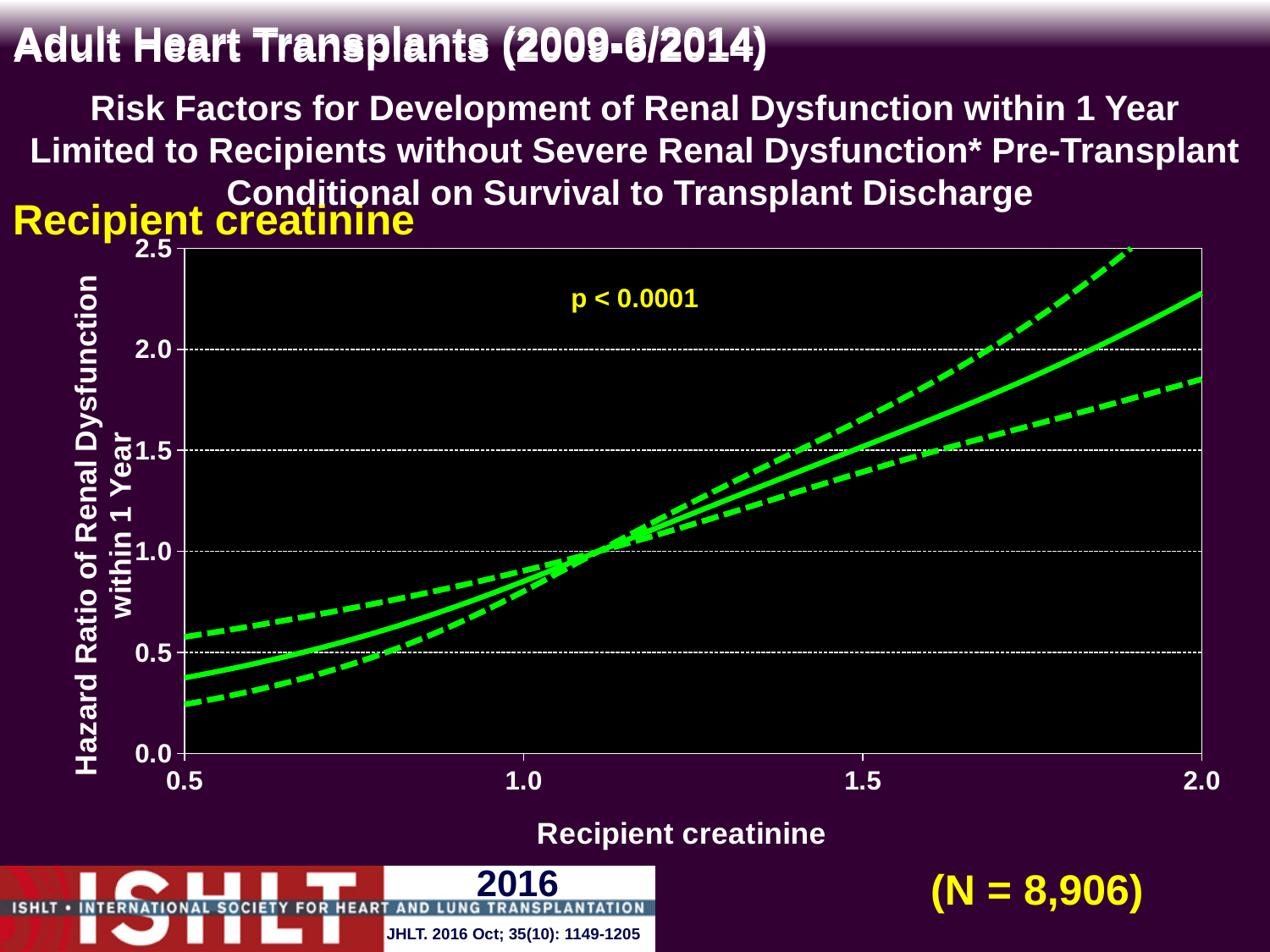
Does the hazard ratio rise or fall as recipient creatinine increases along the x axis? rises Is the lower dashed line at a recipient creatinine of 2.0 greater or less than 1.5? greater What is the label of the x axis? Recipient creatinine Is the hazard ratio on the solid line at a recipient creatinine of 2.0 greater or less than 2.0? greater What kind of chart is shown on the slide? line chart What p-value is printed on the chart? p < 0.0001 Is the upper dashed line at a recipient creatinine of 0.5 greater or less than 1.0? less What is the highest value shown on the y axis? 2.5 How many lines are plotted on the chart? 3 What sample size (N) is printed on the slide? N = 8,906